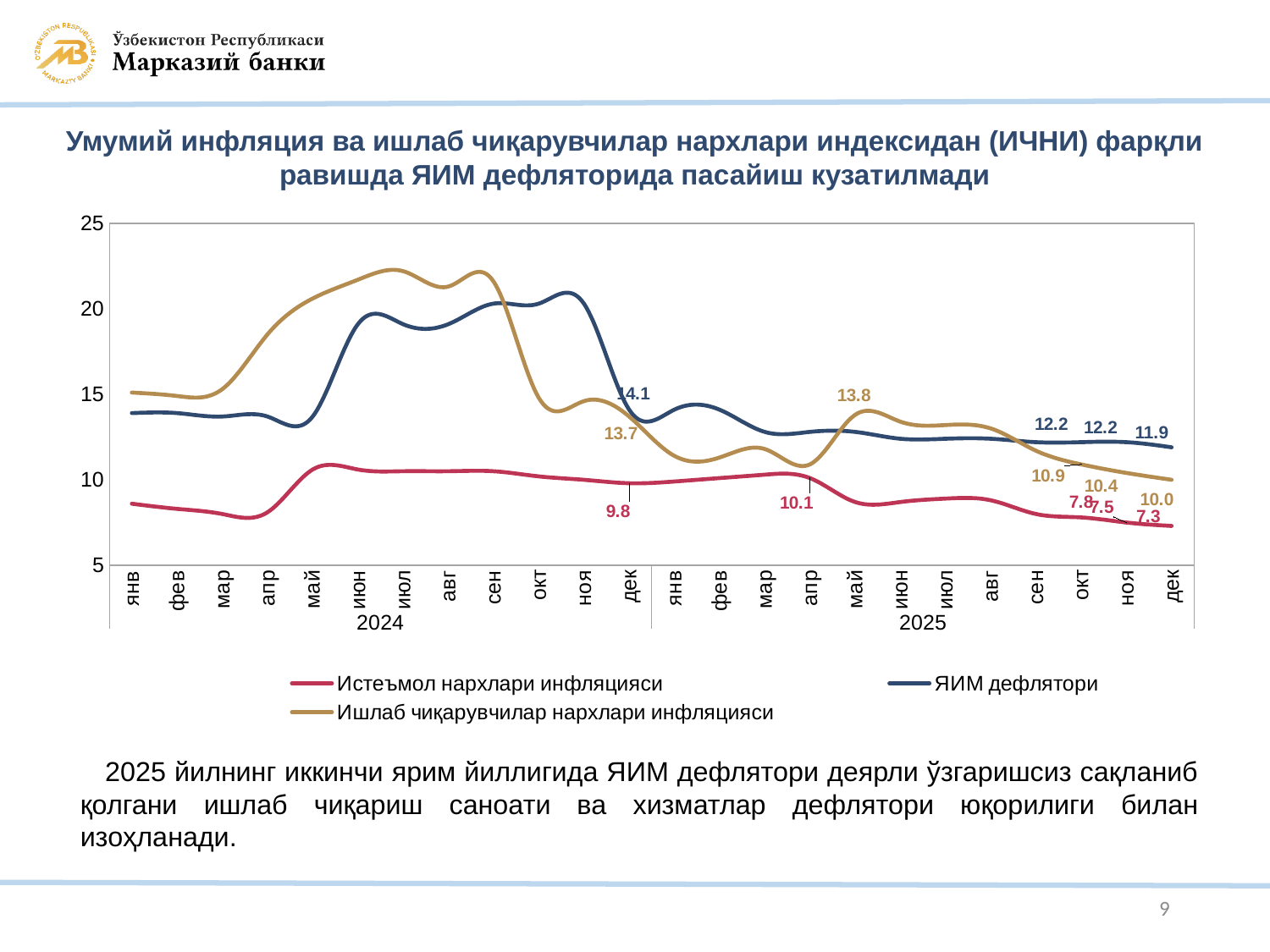
What is the value of Ишлаб чиқарувчилар нархлари инфляцияси in December 2024? 13.7 How many months are shown on the x axis? 24 Is the value of Ишлаб чиқарувчилар нархлари инфляцияси in July 2024 greater or less than 20? greater In December 2024, which is larger: ЯИМ дефлятори or Ишлаб чиқарувчилар нархлари инфляцияси? ЯИМ дефлятори What is the value of ЯИМ дефлятори in December 2024? 14.1 What is the value of Истеъмол нархлари инфляцияси in December 2024? 9.8 What is the value of Ишлаб чиқарувчилар нархлари инфляцияси in May 2025? 13.8 What is the difference between ЯИМ дефлятори and Истеъмол нархлари инфляцияси in December 2024? 4.3 How many series does the legend list? 3 What kind of chart is shown on the slide? line chart Does Истеъмол нархлари инфляцияси rise or fall from April 2025 to December 2025? fall What is the value of Истеъмол нархлари инфляцияси in April 2025? 10.1